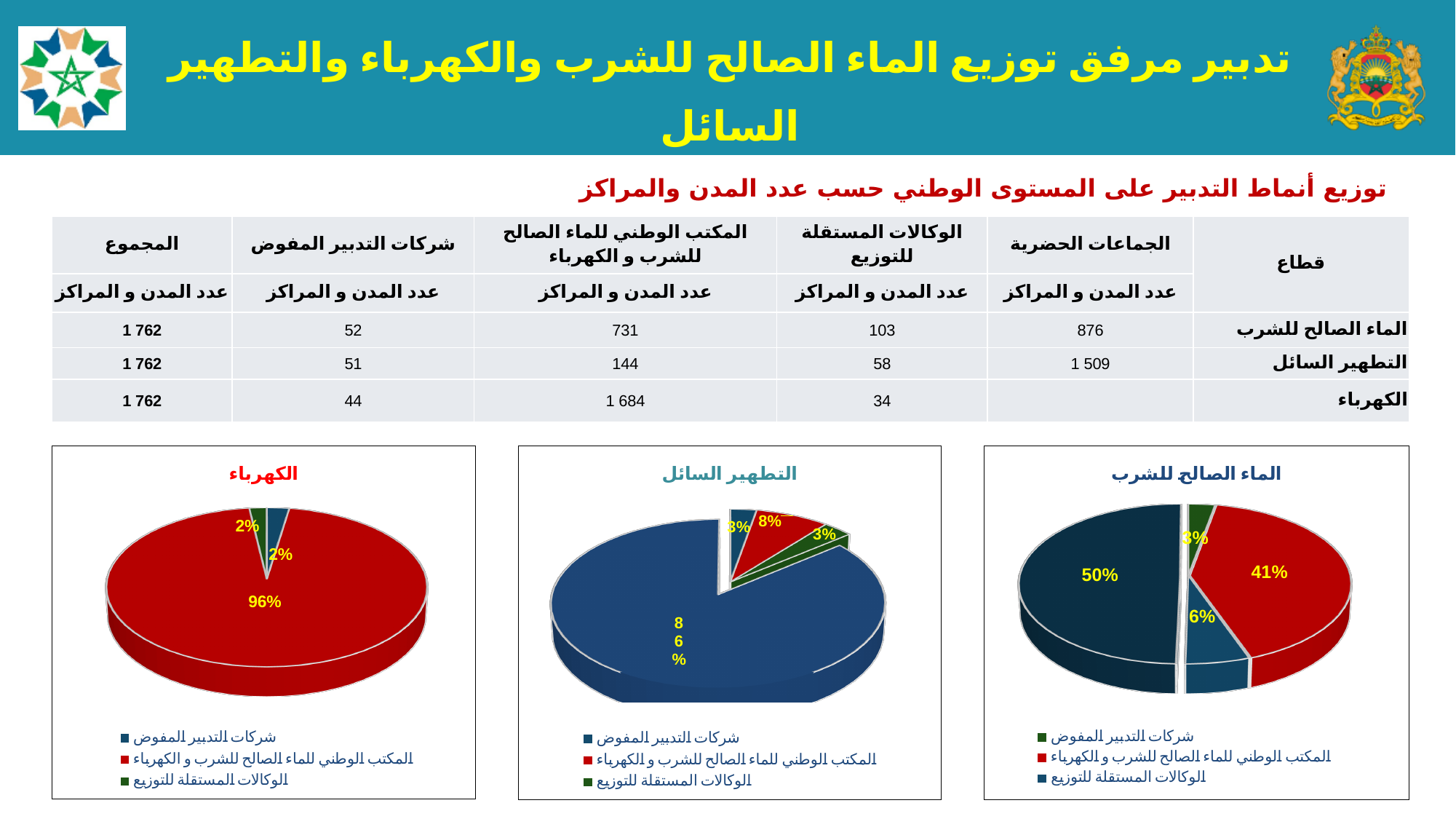
In the الماء الصالح للشرب pie chart, what share is shown for الوكالات المستقلة للتوزيع? 6% In the الماء الصالح للشرب pie chart, what is the difference between the share of المكتب الوطني للماء الصالح للشرب و الكهرباء and the share of الوكالات المستقلة للتوزيع? 35% In the التطهير السائل pie chart, what share is shown for المكتب الوطني للماء الصالح للشرب و الكهرباء? 8% How many pie charts are shown on the slide? 3 How many entries does the legend of the الكهرباء pie chart list? 3 In the الكهرباء pie chart, what share is shown for المكتب الوطني للماء الصالح للشرب و الكهرباء? 96% In the الماء الصالح للشرب pie chart, which has the larger share: المكتب الوطني للماء الصالح للشرب و الكهرباء or الوكالات المستقلة للتوزيع? المكتب الوطني للماء الصالح للشرب و الكهرباء What kind of chart is used for the three charts at the bottom of the slide? Pie chart In the الكهرباء pie chart, what is the share of the largest slice? 96% In the التطهير السائل pie chart, what is the share of the largest slice? 86%